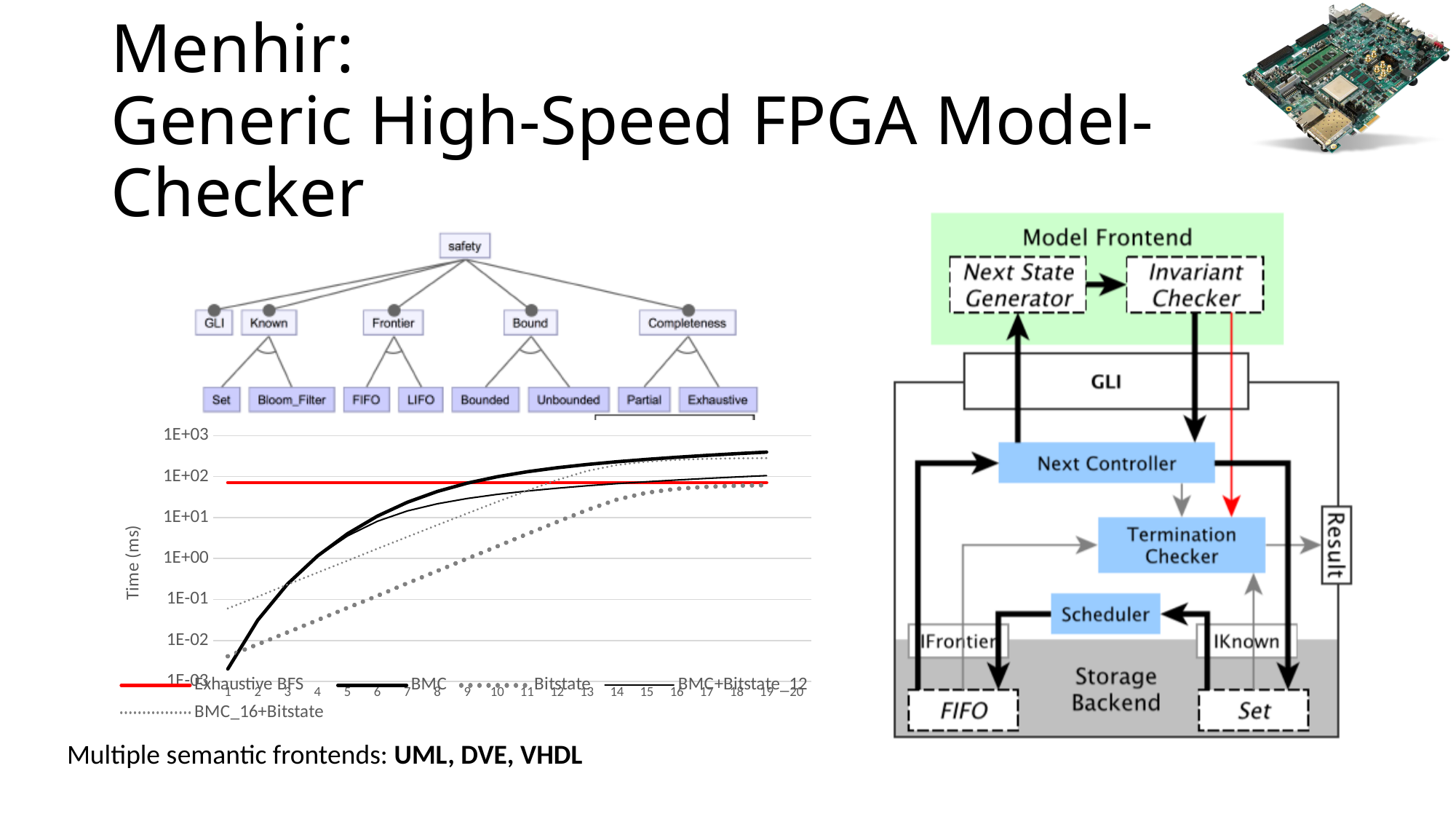
How many series does the legend of the line chart list? 5 What is the label of the y-axis of the line chart? Time (ms) What kind of chart is shown on the left of the slide below the tree diagram? line chart How many x-axis points does the line chart have? 20 In the line chart, is the value for Exhaustive BFS at x=10 greater or less than 1E+01? greater In the line chart, at x=5, which is larger: BMC or Bitstate? BMC In the line chart, is the value for Exhaustive BFS at x=10 greater or less than 1E+02? less In the line chart, does the Exhaustive BFS series rise, fall, or stay flat across the x axis? stay flat In the line chart, does the BMC series rise or fall as x increases from 1 to 20? rise Which series in the line chart is drawn as a red line? Exhaustive BFS In the line chart, is the value for Bitstate at x=1 greater or less than 1E-01? less